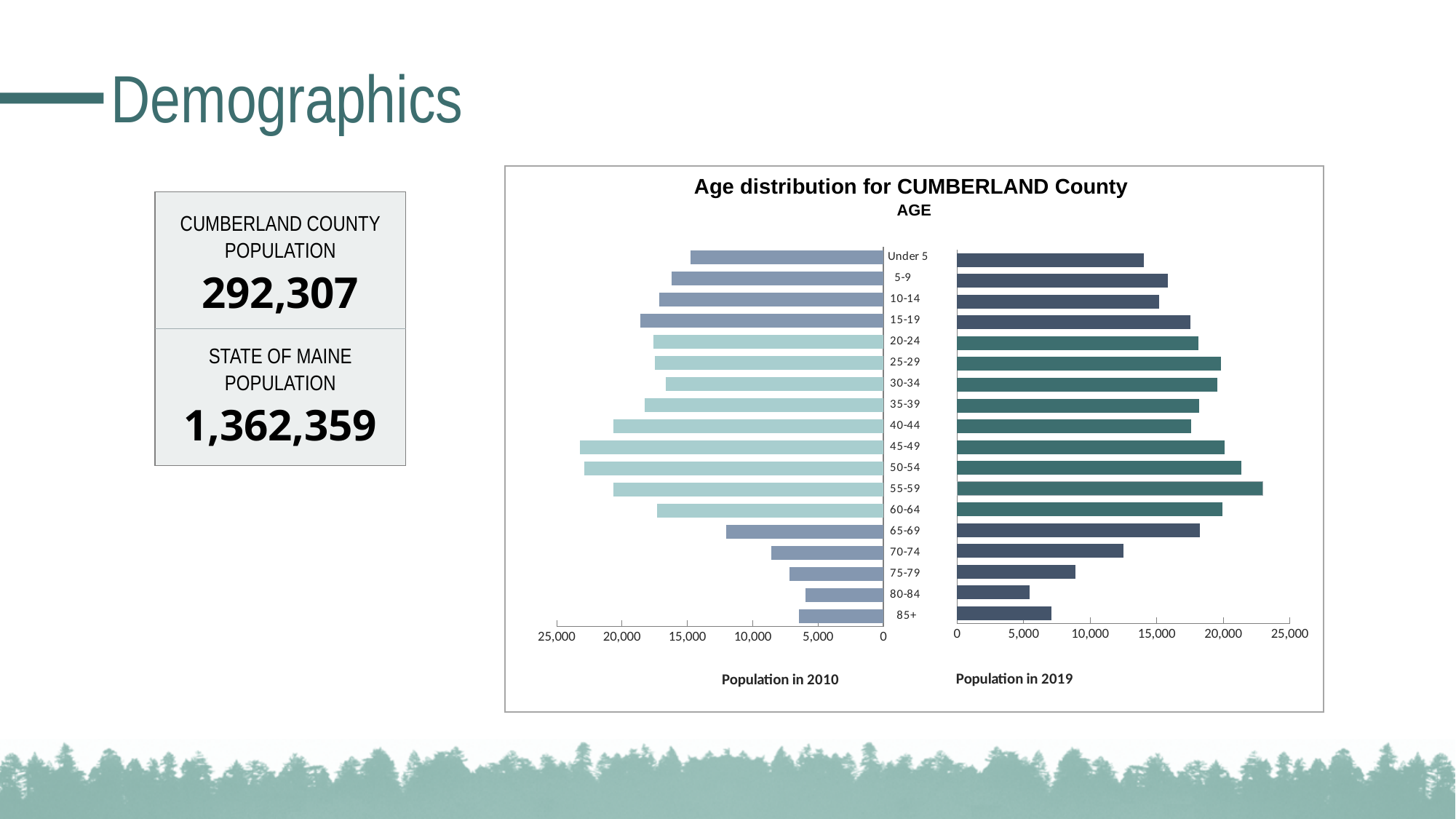
Which age group has the lowest value in the Population in 2019 series? 80-84 Is the Population in 2019 value for the 55-59 age group greater or less than 20,000? greater Is the Population in 2010 value for the 65-69 age group greater or less than 10,000? greater What is the title of the chart? Age distribution for CUMBERLAND County For the 70-74 age group, which is larger: the Population in 2010 or the Population in 2019? Population in 2019 How many age groups are plotted in the chart? 18 How many population series does the chart show? 2 Is the Population in 2019 value for the 75-79 age group greater or less than 10,000? less In the Population in 2010 series, which is larger: the 45-49 age group or the 85+ age group? 45-49 What type of chart is shown on the slide? Bar chart Which age group has the highest value in the Population in 2019 series? 55-59